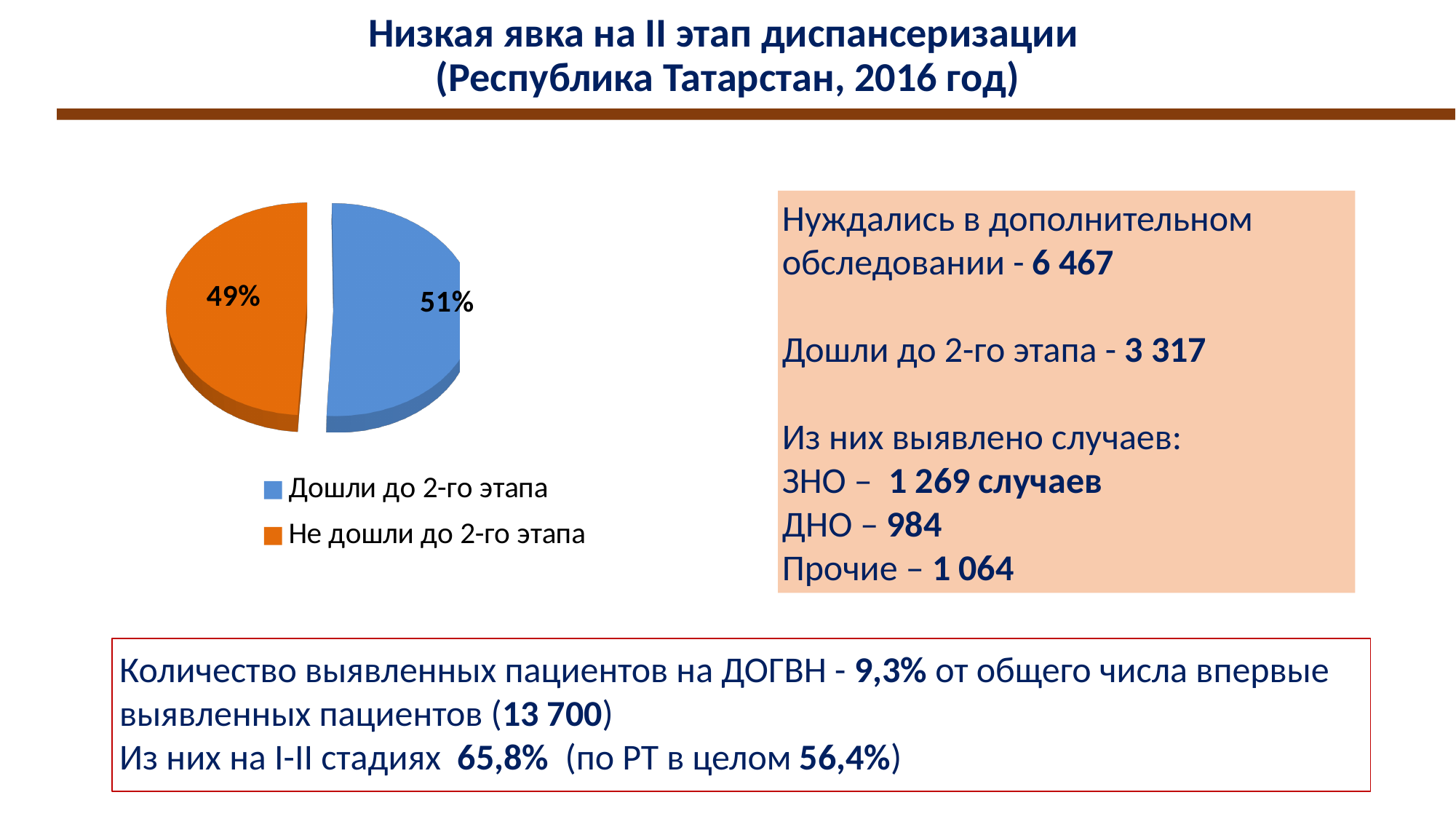
What kind of chart is shown on the slide? Pie chart How many entries does the legend of the pie chart list? 2 What colour is the "Дошли до 2-го этапа" slice in the pie chart? Blue Which slice of the pie chart is the largest? Дошли до 2-го этапа Which is larger in the pie chart: "Дошли до 2-го этапа" or "Не дошли до 2-го этапа"? Дошли до 2-го этапа What is the difference in percentage points between the "Дошли до 2-го этапа" and "Не дошли до 2-го этапа" slices? 2 percentage points What share of the pie chart is labelled "Не дошли до 2-го этапа"? 49% What colour is the "Не дошли до 2-го этапа" slice in the pie chart? Orange What share of the pie chart is labelled "Дошли до 2-го этапа"? 51% Which slice of the pie chart is the smallest? Не дошли до 2-го этапа How many slices does the pie chart have? 2